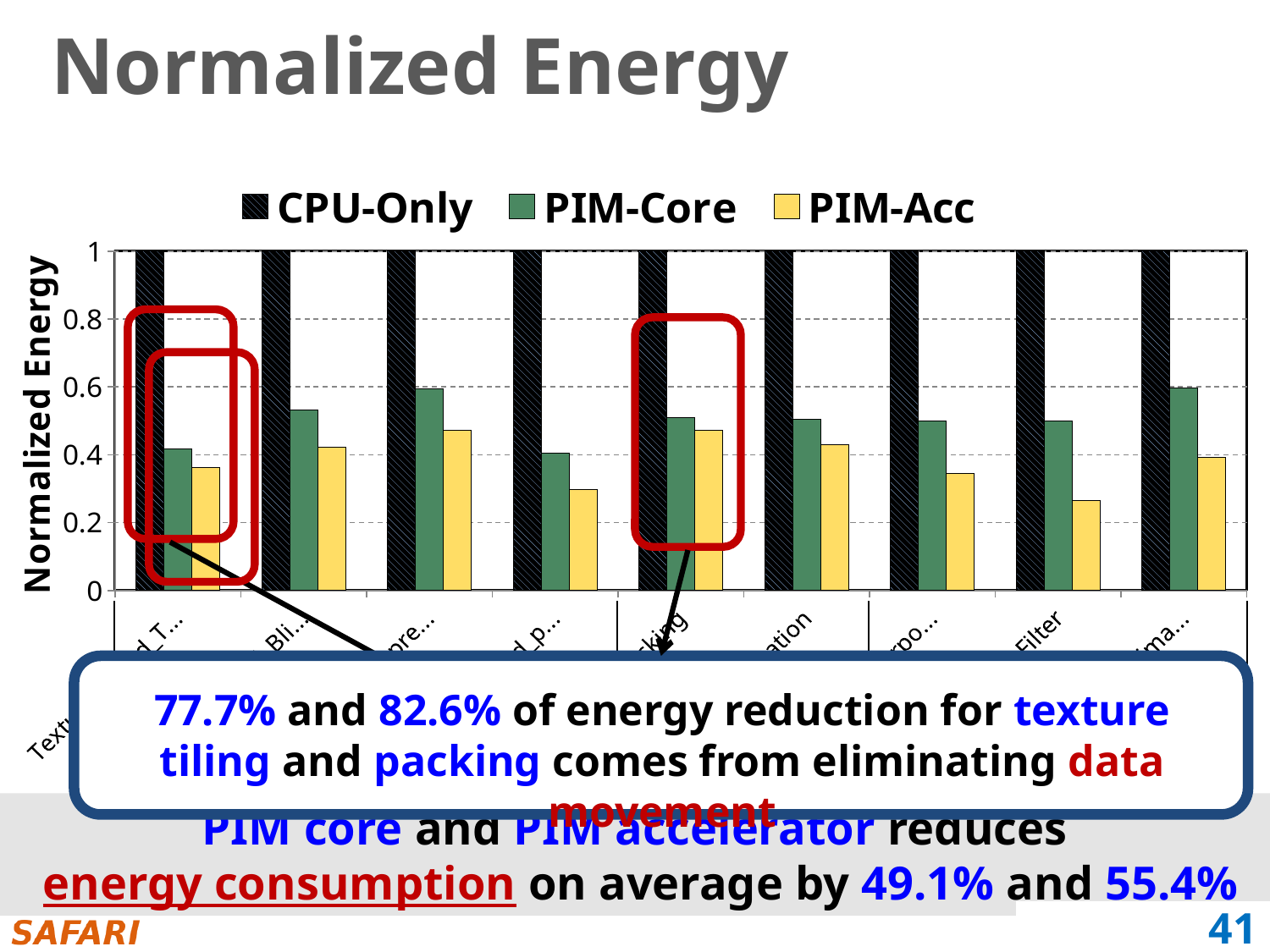
Which series has the highest bar in every category? CPU-Only How many series does the legend list? 3 Is the PIM-Acc value for Filter greater or less than 0.4? less Which series are listed in the legend? CPU-Only, PIM-Core, PIM-Acc How many groups of bars (categories) are plotted? 9 What is the normalized energy value of the CPU-Only series for the Filter category? 1 What is the label of the y axis? Normalized Energy For the Filter category, which is larger: the PIM-Core value or the PIM-Acc value? PIM-Core Which series has the lowest bar for the Filter category? PIM-Acc Is the PIM-Core value for Filter greater or less than 0.4? greater What kind of chart is shown on the slide? bar chart Is the PIM-Acc value for Filter greater or less than 0.2? greater